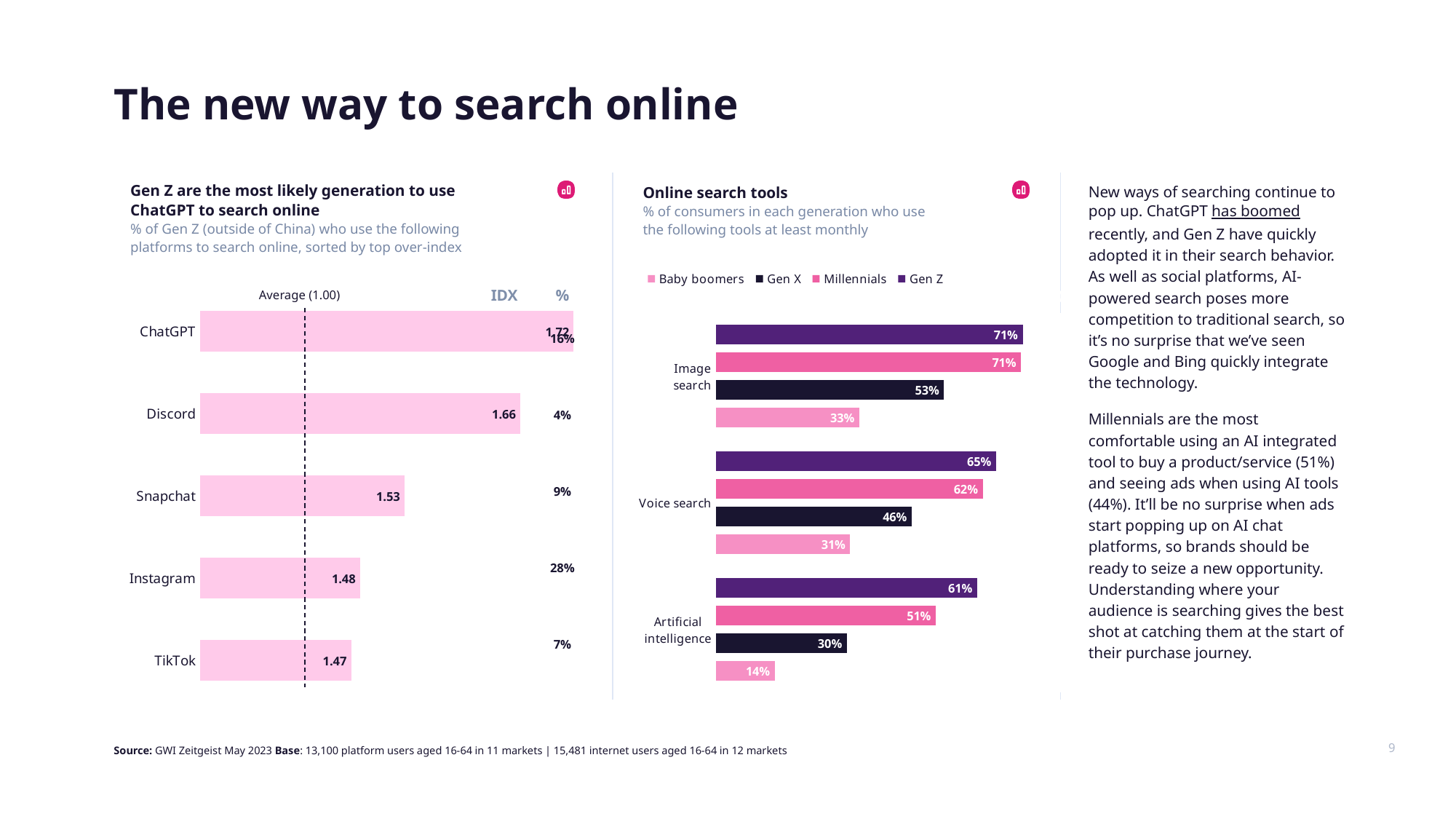
In the left chart about Gen Z platforms used to search online, which platform has the lowest IDX value? TikTok In the 'Online search tools' chart, how many series does the legend list? 4 In the 'Online search tools' chart, what percentage of Gen Z use image search at least monthly? 71% In the left chart about Gen Z platforms used to search online, how many platforms are shown? 5 What type of chart is the 'Online search tools' chart? Bar chart In the 'Online search tools' chart, what percentage of Baby boomers use artificial intelligence tools at least monthly? 14% In the 'Online search tools' chart, what is the value for Gen X for voice search? 46% In the left chart about Gen Z platforms used to search online, what is the IDX value for Discord? 1.66 In the left chart about Gen Z platforms used to search online, what percentage of Gen Z use Instagram to search online? 28% In the 'Online search tools' chart, which generation has the lowest value for artificial intelligence? Baby boomers In the 'Online search tools' chart, what is the difference between the Gen Z and Baby boomers values for voice search? 34 percentage points In the 'Online search tools' chart, is the Millennials value for artificial intelligence larger or smaller than the Gen X value? larger